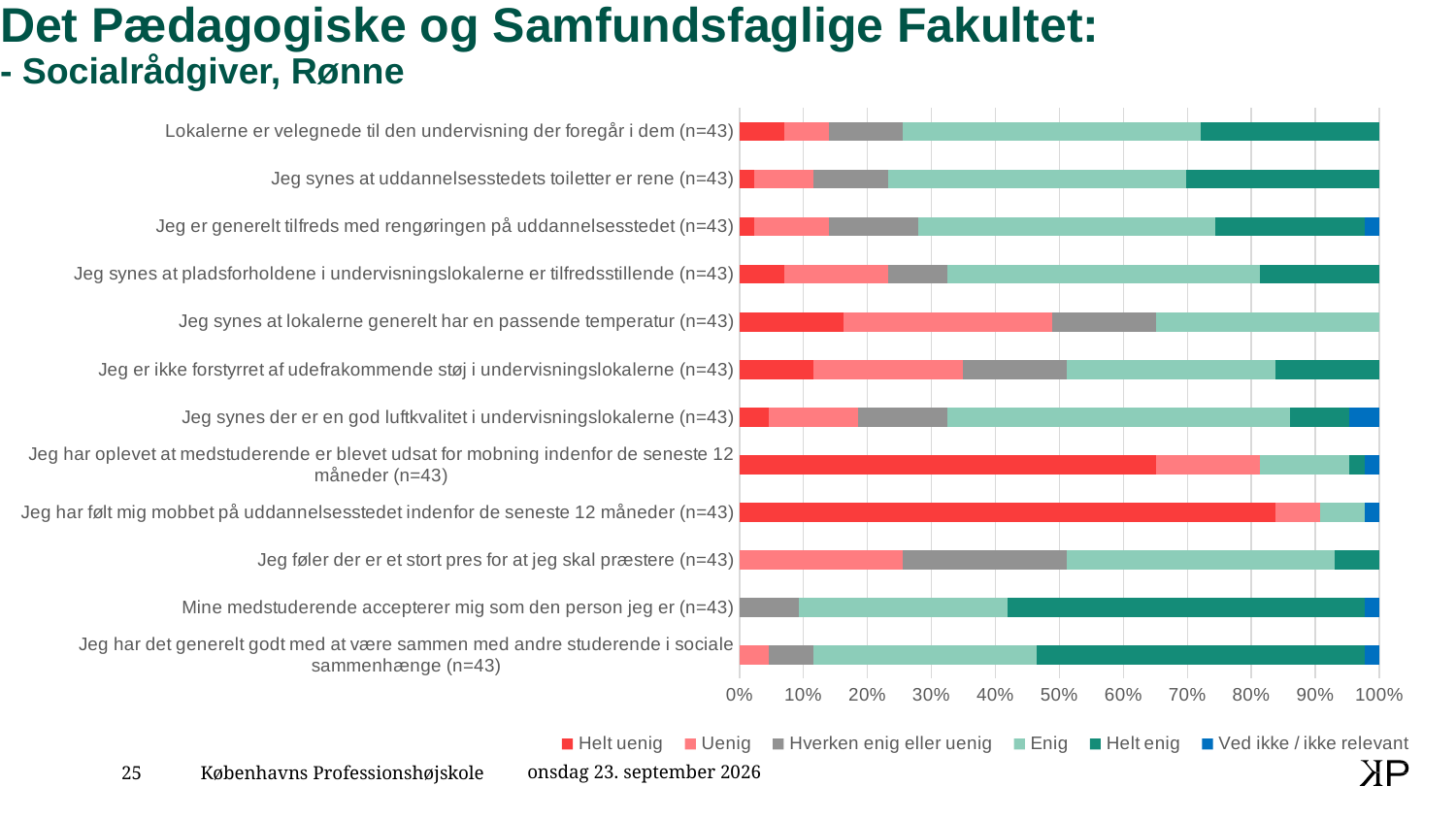
How many statements (categories) are plotted in the chart? 12 Is the 'Helt enig' share for 'Mine medstuderende accepterer mig som den person jeg er (n=43)' greater or less than 50%? greater How many series does the legend list? 6 Is the 'Helt uenig' share for 'Jeg har oplevet at medstuderende er blevet udsat for mobning indenfor de seneste 12 måneder (n=43)' greater or less than 60%? greater What is the last entry in the chart's legend? Ved ikke / ikke relevant Is the 'Uenig' share for 'Jeg føler der er et stort pres for at jeg skal præstere (n=43)' greater or less than 20%? greater What is the first entry in the chart's legend? Helt uenig Which has the larger 'Helt uenig' share: 'Jeg har følt mig mobbet på uddannelsesstedet indenfor de seneste 12 måneder (n=43)' or 'Jeg har oplevet at medstuderende er blevet udsat for mobning indenfor de seneste 12 måneder (n=43)'? Jeg har følt mig mobbet på uddannelsesstedet indenfor de seneste 12 måneder (n=43) Which statement has the largest 'Helt uenig' share? Jeg har følt mig mobbet på uddannelsesstedet indenfor de seneste 12 måneder (n=43) What kind of chart is shown on the slide? Stacked bar chart